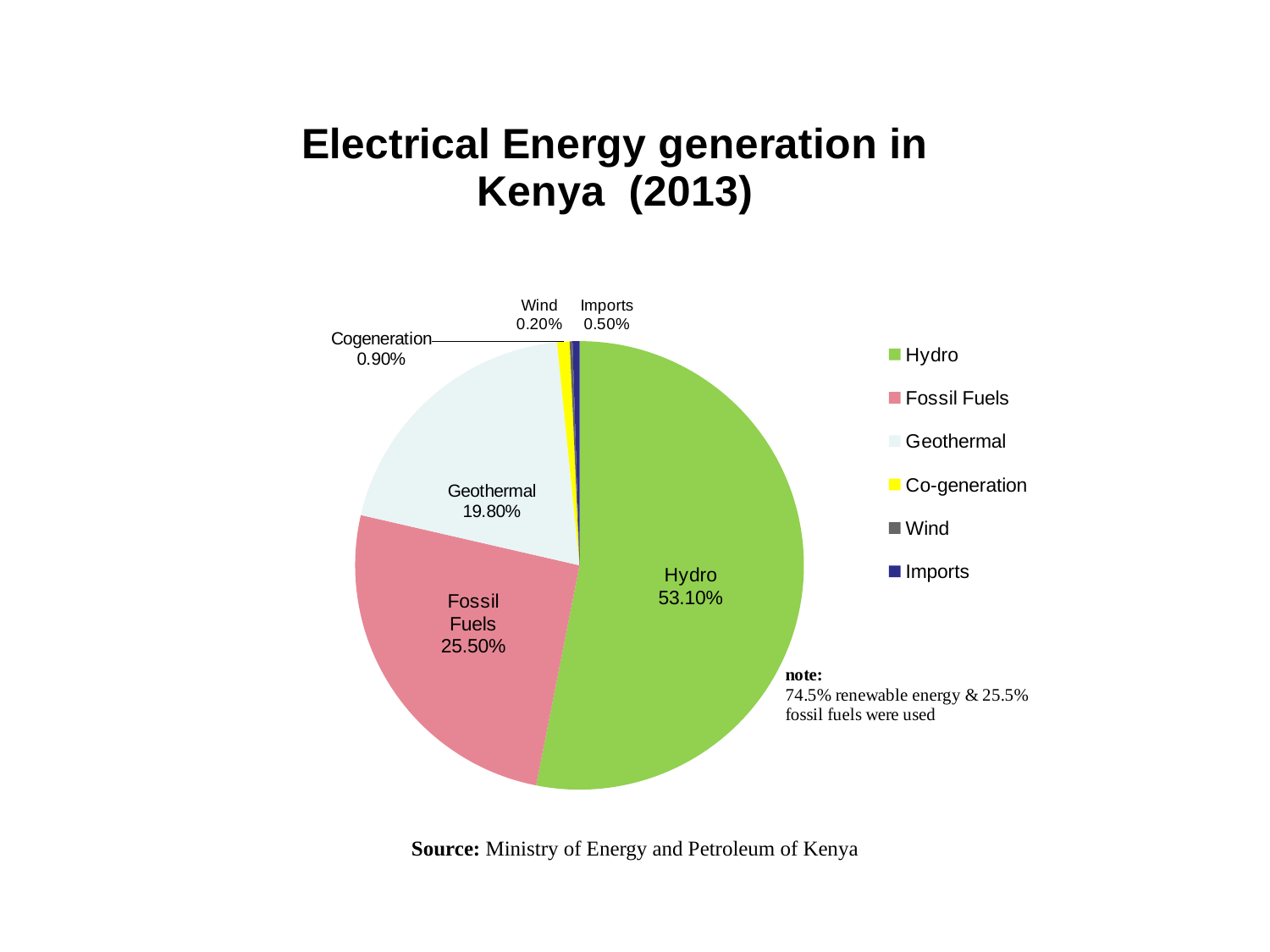
Which category has the smallest slice of the pie? Wind What colour is the Hydro slice in the pie chart? Green Which category has the largest slice of the pie? Hydro What is the value shown for Fossil Fuels? 25.50% What kind of chart is shown on the slide? Pie chart What share of electrical energy generation does Hydro account for? 53.10% How many categories are shown in the pie chart? 6 What percentage is labelled for Geothermal? 19.80% What is the value shown for Imports? 0.50% What is the value shown for Wind? 0.20% What is the difference between the Hydro and Fossil Fuels shares? 27.60% Which is larger, the Geothermal share or the Fossil Fuels share? Fossil Fuels